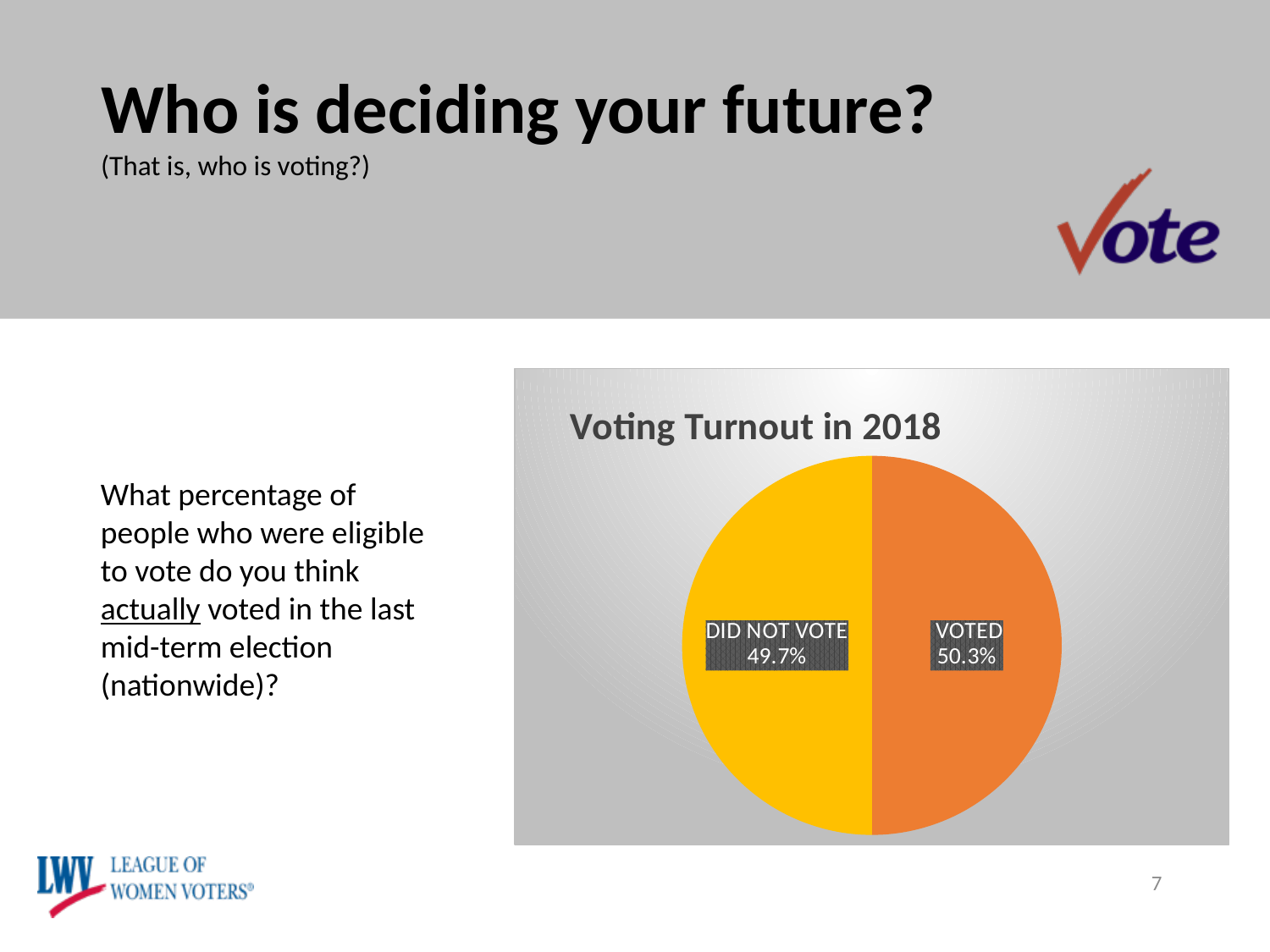
Which slice of the pie is larger, VOTED or DID NOT VOTE? VOTED What percentage of the pie is labelled DID NOT VOTE? 49.7% What percentage of the pie is labelled VOTED? 50.3% What is the difference in percentage points between the VOTED and DID NOT VOTE slices? 0.6 How many slices does the pie chart have? 2 What is the title of the chart? Voting Turnout in 2018 What kind of chart is shown on the slide? pie chart What colour is the VOTED slice of the pie? orange Which category has the largest share of the pie? VOTED What share of the pie does the DID NOT VOTE slice represent? 49.7% Is the value for VOTED greater or less than 50%? greater Which category has the smallest share of the pie? DID NOT VOTE